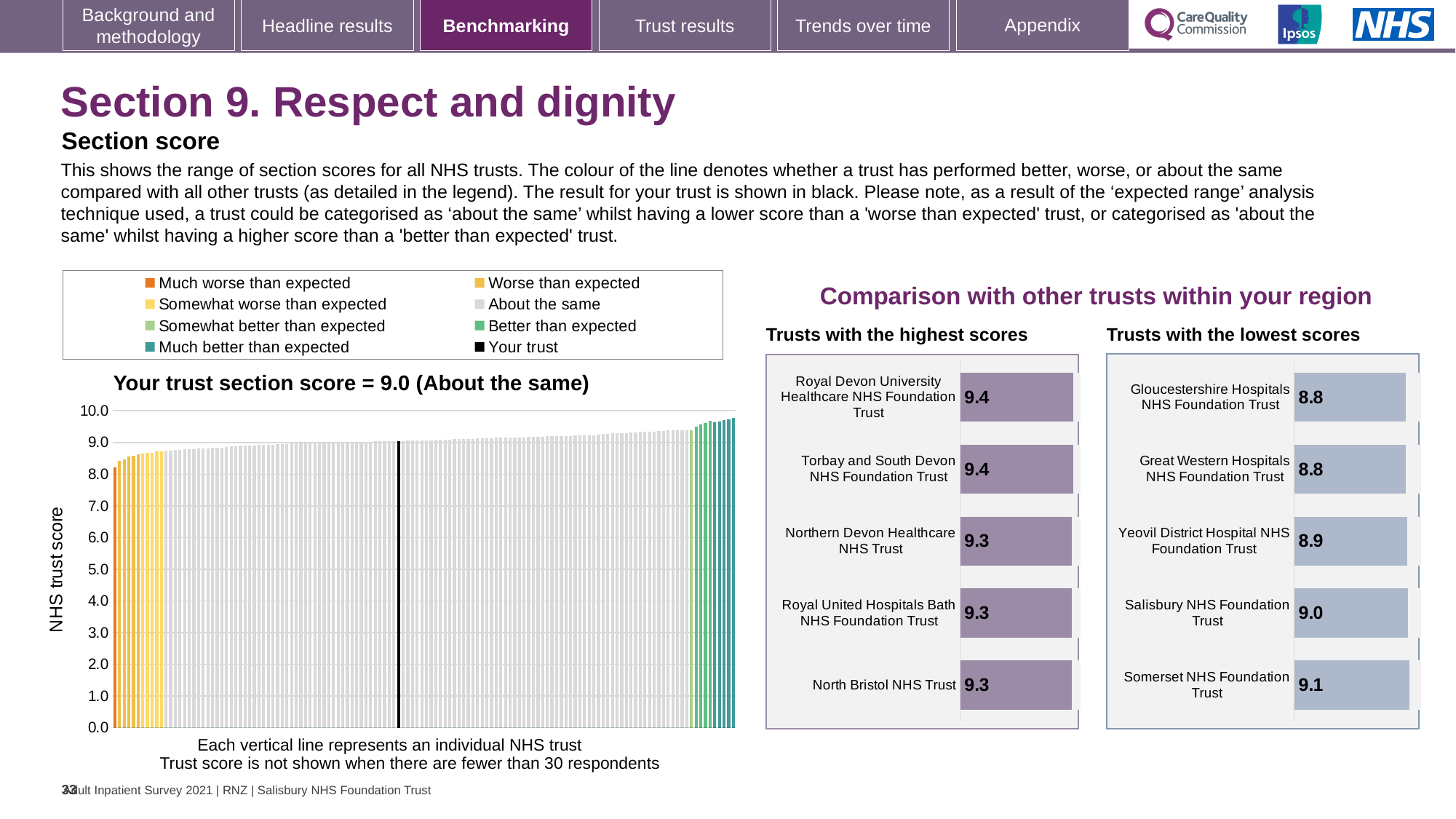
In the 'Trusts with the lowest scores' chart, which trust has the highest score? Somerset NHS Foundation Trust In the 'Your trust section score' chart, is the value of the rightmost bar greater or less than 9.0? greater In the 'Trusts with the highest scores' chart, how many trusts are shown? 5 In the 'Trusts with the lowest scores' chart, what is the difference between the scores of Somerset NHS Foundation Trust and Gloucestershire Hospitals NHS Foundation Trust? 0.3 In the 'Trusts with the lowest scores' chart, what is the score for Salisbury NHS Foundation Trust? 9.0 In the 'Your trust section score' chart, what is the label on the vertical axis? NHS trust score In the 'Your trust section score' chart, what is the section score for your trust? 9.0 In the 'Trusts with the highest scores' chart, what is the score for Northern Devon Healthcare NHS Trust? 9.3 In the 'Trusts with the highest scores' chart, what is the difference between the scores of Torbay and South Devon NHS Foundation Trust and North Bristol NHS Trust? 0.1 In the 'Your trust section score' chart, do the bar values rise or fall from left to right along the x axis? rise In the 'Your trust section score' chart, what kind of chart is shown? bar chart In the 'Your trust section score' chart, how many entries does the legend list? 8